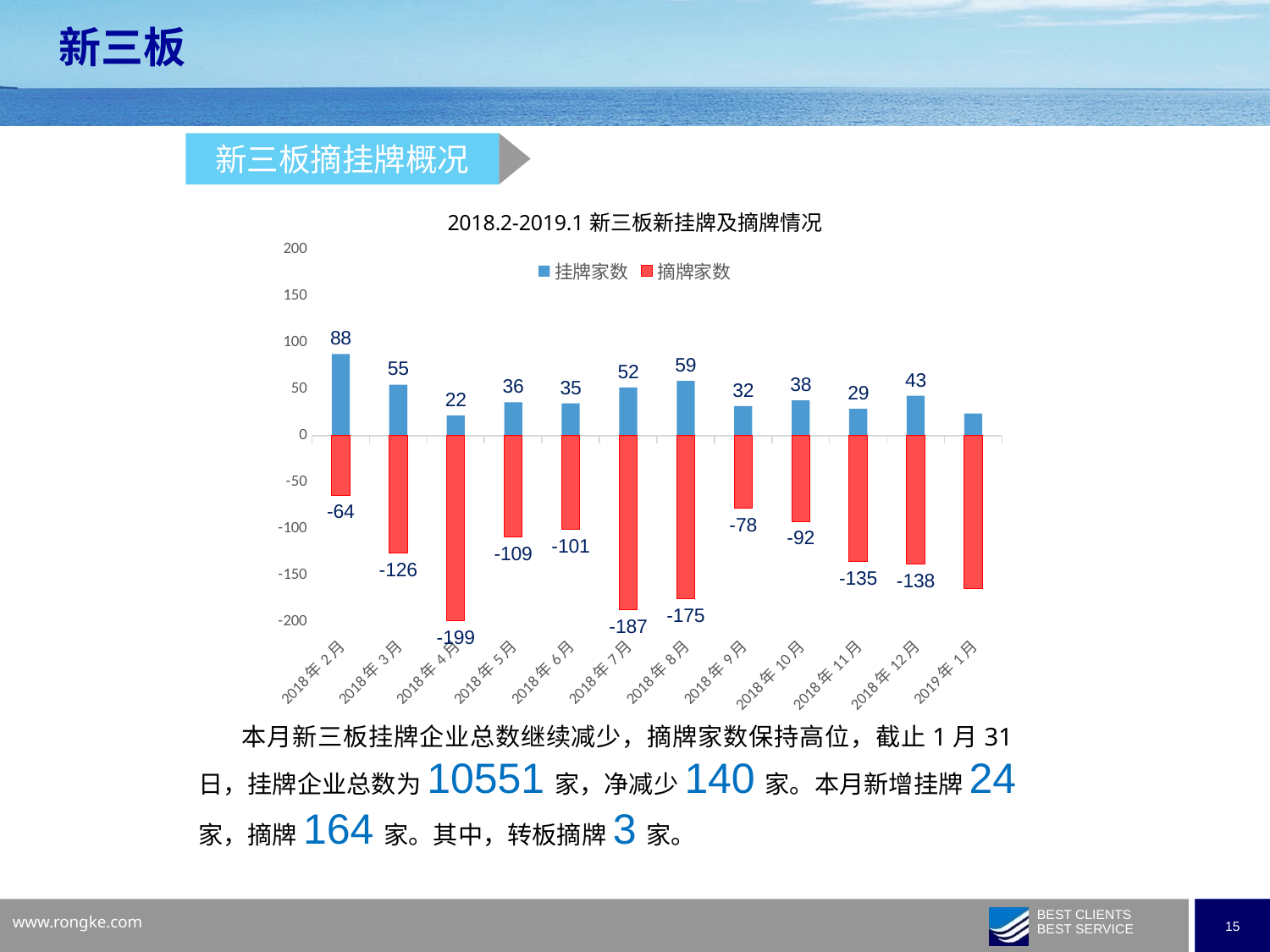
Which month has the lowest (most negative) 摘牌家数 value? 2018年4月 What is the 挂牌家数 value for 2018年2月? 88 How many months are shown on the x axis of the chart? 12 What is the difference between the 摘牌家数 values for 2018年7月 and 2018年8月? 12 What is the 摘牌家数 value for 2018年9月? -78 Which is larger, the 挂牌家数 for 2018年3月 or for 2018年12月? 2018年3月 Which month has the highest 挂牌家数? 2018年2月 How many series does the chart legend list? 2 Is the 摘牌家数 value for 2019年1月 greater or less than -150? less What is the difference between the 挂牌家数 values for 2018年8月 and 2018年7月? 7 What type of chart is shown on the slide? bar chart What is the 摘牌家数 value for 2018年4月? -199